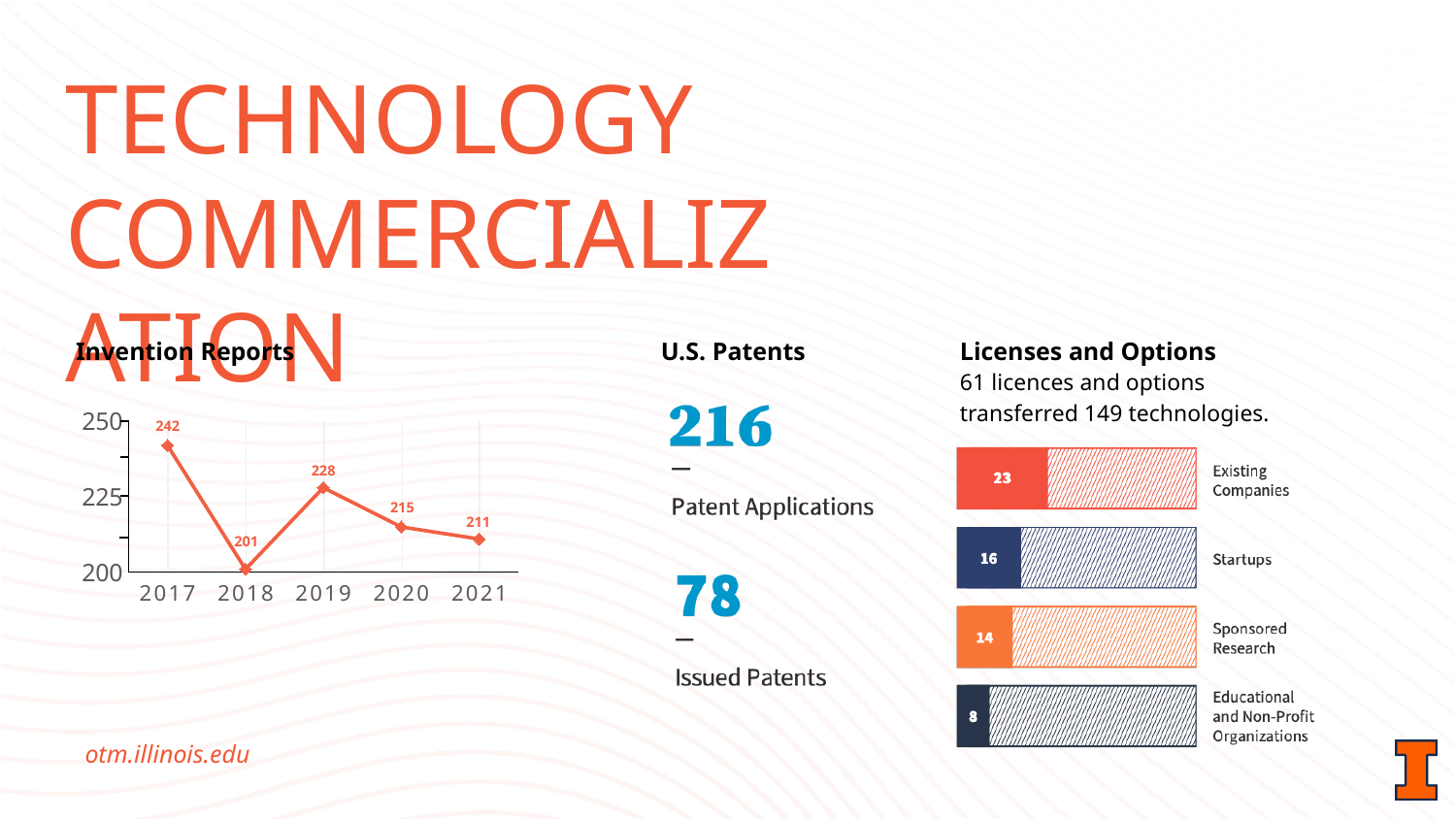
In the Invention Reports chart, which year has the lowest value? 2018 In the Invention Reports chart, which year has the highest value? 2017 In the Invention Reports chart, what is the value for 2017? 242 In the Invention Reports chart, what is the value for 2021? 211 In the Invention Reports chart, do the values rise or fall from 2019 to 2021? fall In the Invention Reports chart, what is the difference between the values for 2017 and 2018? 41 In the Invention Reports chart, what is the value for 2018? 201 In the Invention Reports chart, which is larger, the value for 2019 or the value for 2020? 2019 What kind of chart is the Invention Reports chart? line chart In the Licenses and Options chart, which category has the highest value? Existing Companies In the Invention Reports chart, how many years are plotted? 5 In the Licenses and Options chart, what is the value for Startups? 16